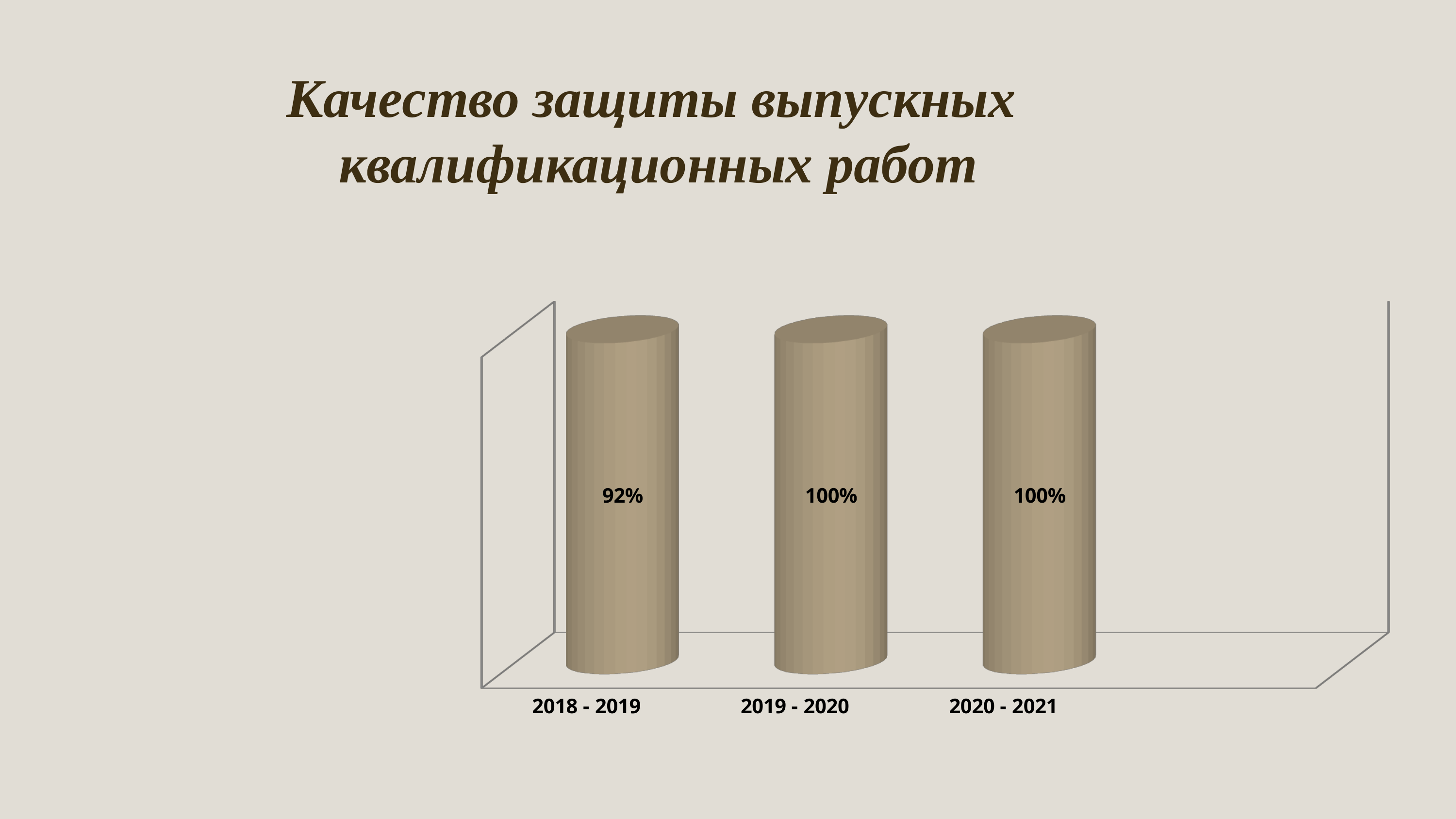
Which is larger, the value for 2018 - 2019 or the value for 2020 - 2021? 2020 - 2021 What is the value for 2019 - 2020? 100% Which category is shown first on the x axis? 2018 - 2019 What is the value for 2020 - 2021? 100% What kind of chart is shown on the slide? bar chart What is the value for 2018 - 2019? 92% How many categories are shown on the x axis? 3 Do the values rise or fall from 2018 - 2019 to 2019 - 2020? rise What is the difference between the values for 2019 - 2020 and 2018 - 2019? 8% Which category has the lowest value? 2018 - 2019 What is the title of the slide? Качество защиты выпускных квалификационных работ